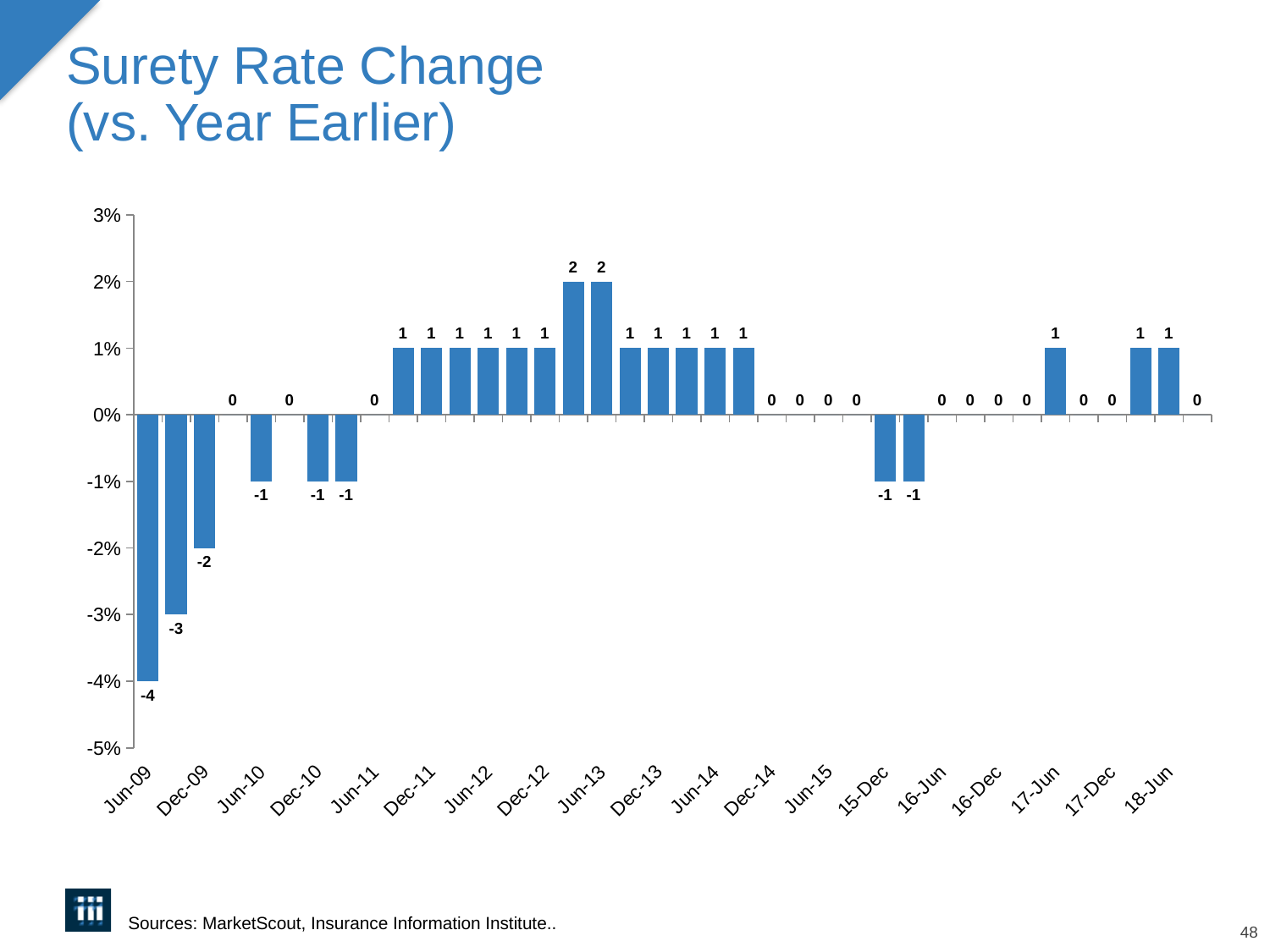
What is the title of the chart? Surety Rate Change (vs. Year Earlier) Do the values rise or fall from Jun-09 to Jun-13? rise Which is larger, the value for Jun-09 or the value for Jun-13? Jun-13 What is the lowest value shown on the chart? -4 What is the surety rate change for 15-Dec? -1 Which period has the lowest surety rate change? Jun-09 What is the surety rate change for Jun-13? 2 What is the surety rate change for Jun-09? -4 What is the highest value shown on the chart? 2 What type of chart is shown on the slide? bar chart What is the difference between the value for Jun-13 and the value for Jun-09? 6 Is the value for Jun-09 greater or less than -3%? less